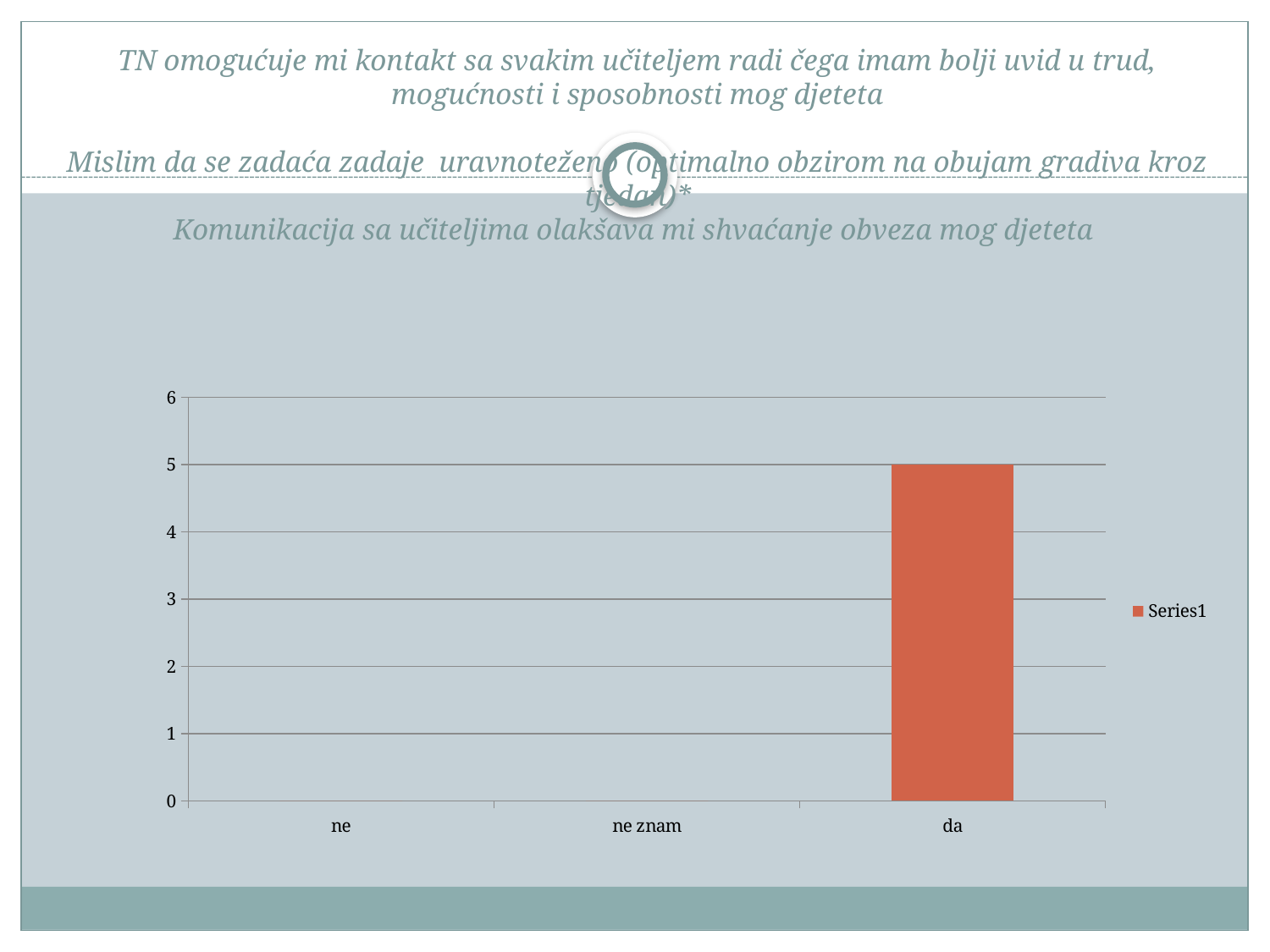
Which is larger, the value for "da" or the value for "ne znam"? da What is the difference between the value for "da" and the value for "ne"? 5 Is the value for "da" greater or less than 4? greater How many categories are shown on the x axis of the chart? 3 What is the value for the category "ne"? 0 How many series does the chart legend list? 1 What type of chart is shown on the slide? bar chart What is the value for the category "da"? 5 What is the value for the category "ne znam"? 0 What is the highest value shown on the vertical axis of the chart? 6 Which category has the highest value in the chart? da What is the name of the series shown in the chart legend? Series1